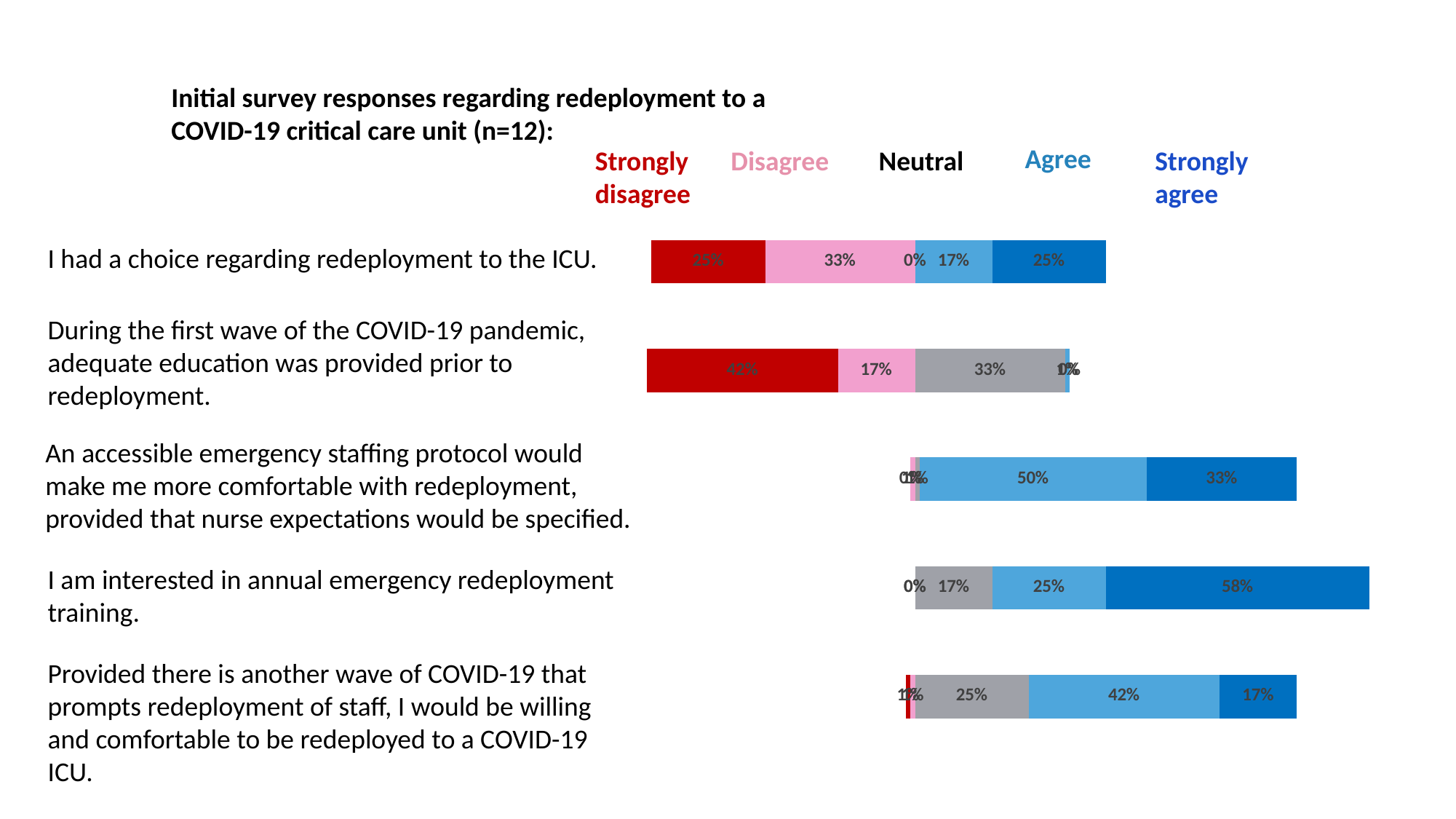
How many response categories does the legend list? 5 What is the difference between the 'Strongly agree' percentage for the annual training statement (58%) and the 'Strongly agree' percentage for the emergency staffing protocol statement (33%)? 25% Which statement has the highest 'Strongly agree' percentage? I am interested in annual emergency redeployment training. What percentage of respondents were neutral on the statement that adequate education was provided prior to redeployment? 33% How many survey statements are plotted in the chart? 5 What percentage of respondents disagreed with the statement 'I had a choice regarding redeployment to the ICU.'? 33% What percentage of respondents strongly disagreed that adequate education was provided prior to redeployment during the first wave? 42% What percentage of respondents agreed that an accessible emergency staffing protocol would make them more comfortable with redeployment? 50% What percentage of respondents strongly agreed with the statement 'I am interested in annual emergency redeployment training.'? 58% For the statement about being willing to be redeployed to a COVID-19 ICU in another wave, which is larger: the 'Agree' share or the 'Strongly agree' share? Agree What kind of chart is shown on the slide? stacked bar chart What percentage of respondents strongly disagreed with the statement 'I had a choice regarding redeployment to the ICU.'? 25%